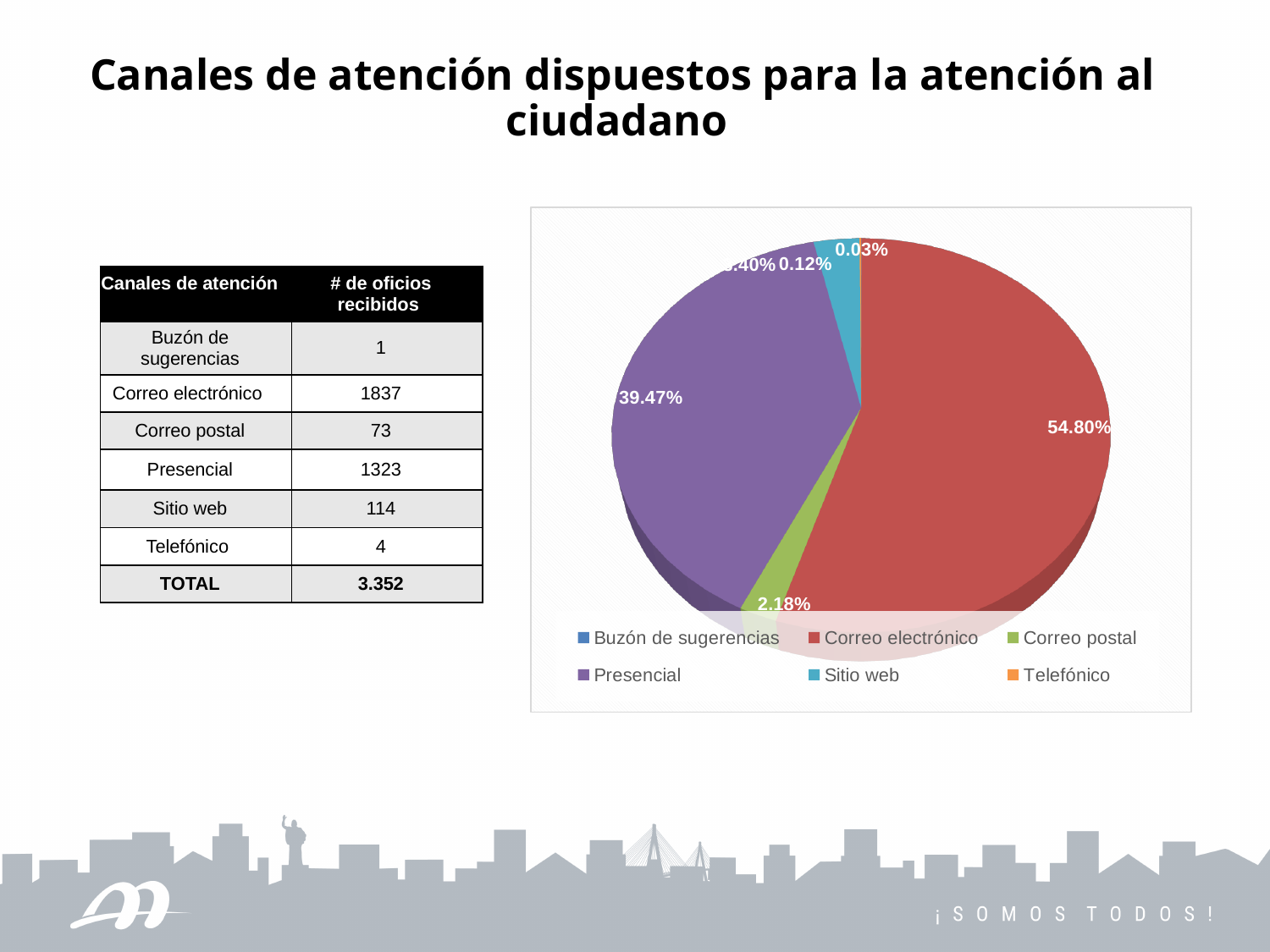
What percentage does the pie chart show for Correo electrónico? 54.80% How many categories does the pie chart's legend list? 6 Is the Presencial slice greater or less than 50% of the pie? less What is the difference in percentage points between the Correo electrónico slice and the Presencial slice? 15.33% What percentage does the pie chart show for Buzón de sugerencias? 0.03% Which category has the smallest slice in the pie chart? Buzón de sugerencias Which slice is larger in the pie chart, Presencial or Correo postal? Presencial What percentage does the pie chart show for Correo postal? 2.18% What colour is the Correo electrónico slice in the pie chart? red What percentage does the pie chart show for Presencial? 39.47% Which category has the largest slice in the pie chart? Correo electrónico What kind of chart is shown on the slide? pie chart